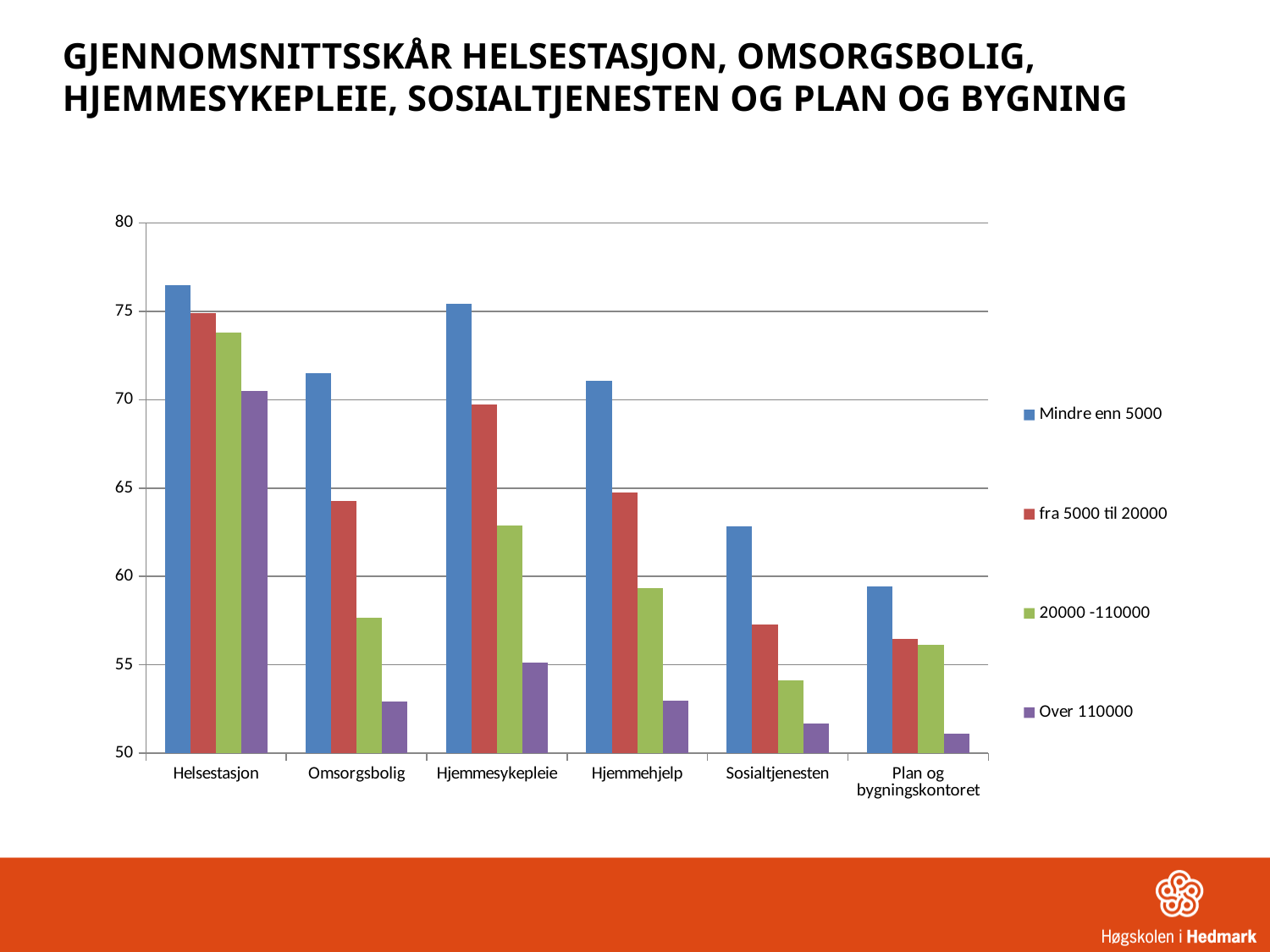
Which category has the lowest value for the 'Mindre enn 5000' series? Plan og bygningskontoret How many categories are shown along the x axis of the chart? 6 Is the 'fra 5000 til 20000' value for Sosialtjenesten greater or less than 60? less Within the Omsorgsbolig category, do the values rise or fall from 'Mindre enn 5000' to 'Over 110000'? fall Is the 'Mindre enn 5000' value for Helsestasjon greater or less than 75? greater Is the 'Over 110000' value for Omsorgsbolig greater or less than 55? less How many series does the chart's legend list? 4 Which is larger: the 'Mindre enn 5000' value for Hjemmesykepleie or for Omsorgsbolig? Hjemmesykepleie Which category has the highest value for the 'Over 110000' series? Helsestasjon What kind of chart is shown on the slide? Bar chart Which series is shown in purple in the chart's legend? Over 110000